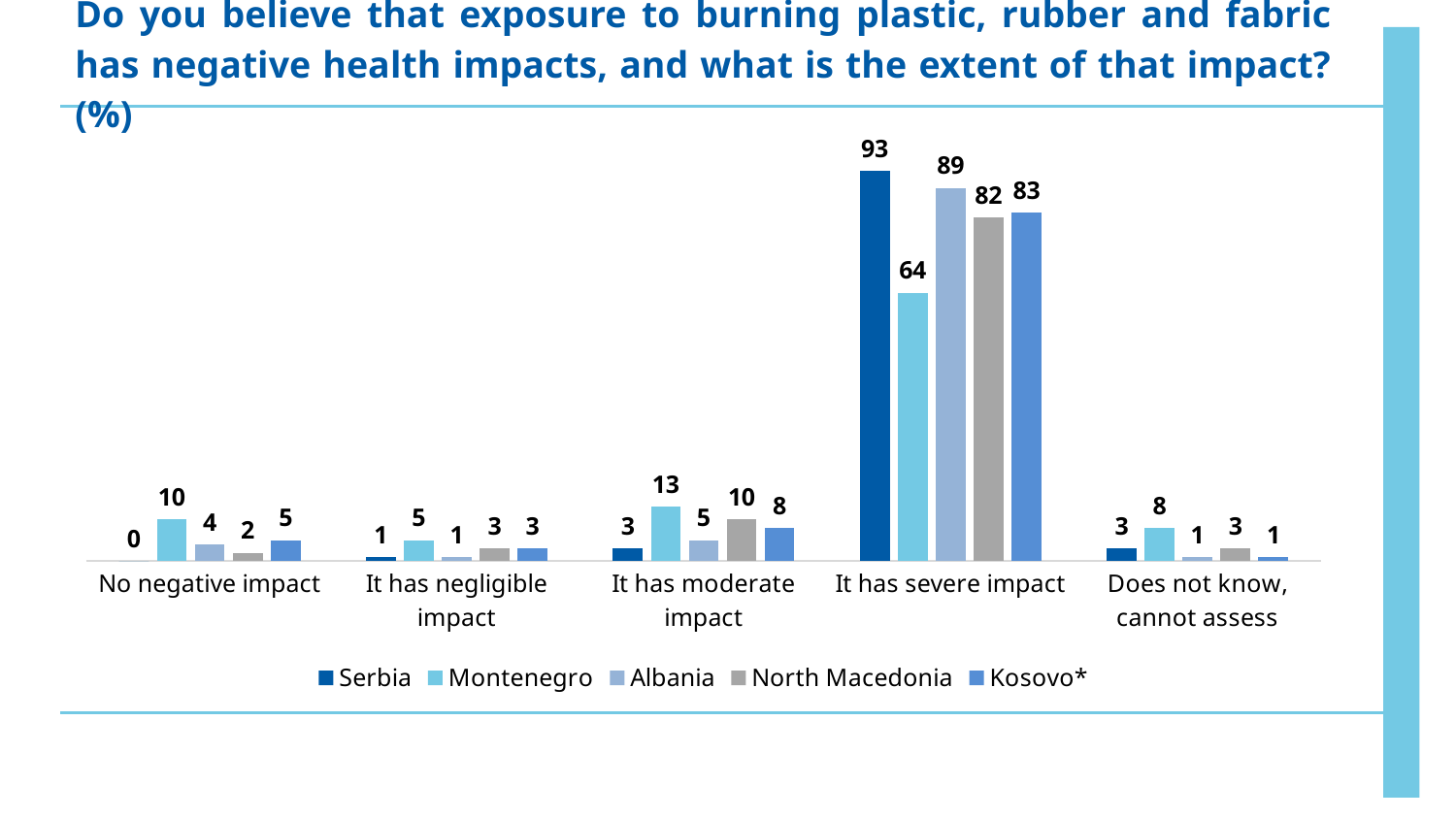
Which series is listed last in the legend? Kosovo* What is the value for North Macedonia in the 'No negative impact' category? 2 What is the value for Kosovo* in the 'Does not know, cannot assess' category? 1 What is the value for Montenegro in the 'It has moderate impact' category? 13 Which country has the highest value in the 'It has severe impact' category? Serbia What kind of chart is shown on the slide? Bar chart Which is larger: Albania's value for 'It has severe impact' or Kosovo*'s value for 'It has severe impact'? Albania Which country has the lowest value in the 'It has severe impact' category? Montenegro How many response categories are shown on the x axis? 5 What is the difference between Serbia and Montenegro in the 'It has severe impact' category? 29 What is the value for Serbia in the 'It has severe impact' category? 93 How many series does the legend list? 5